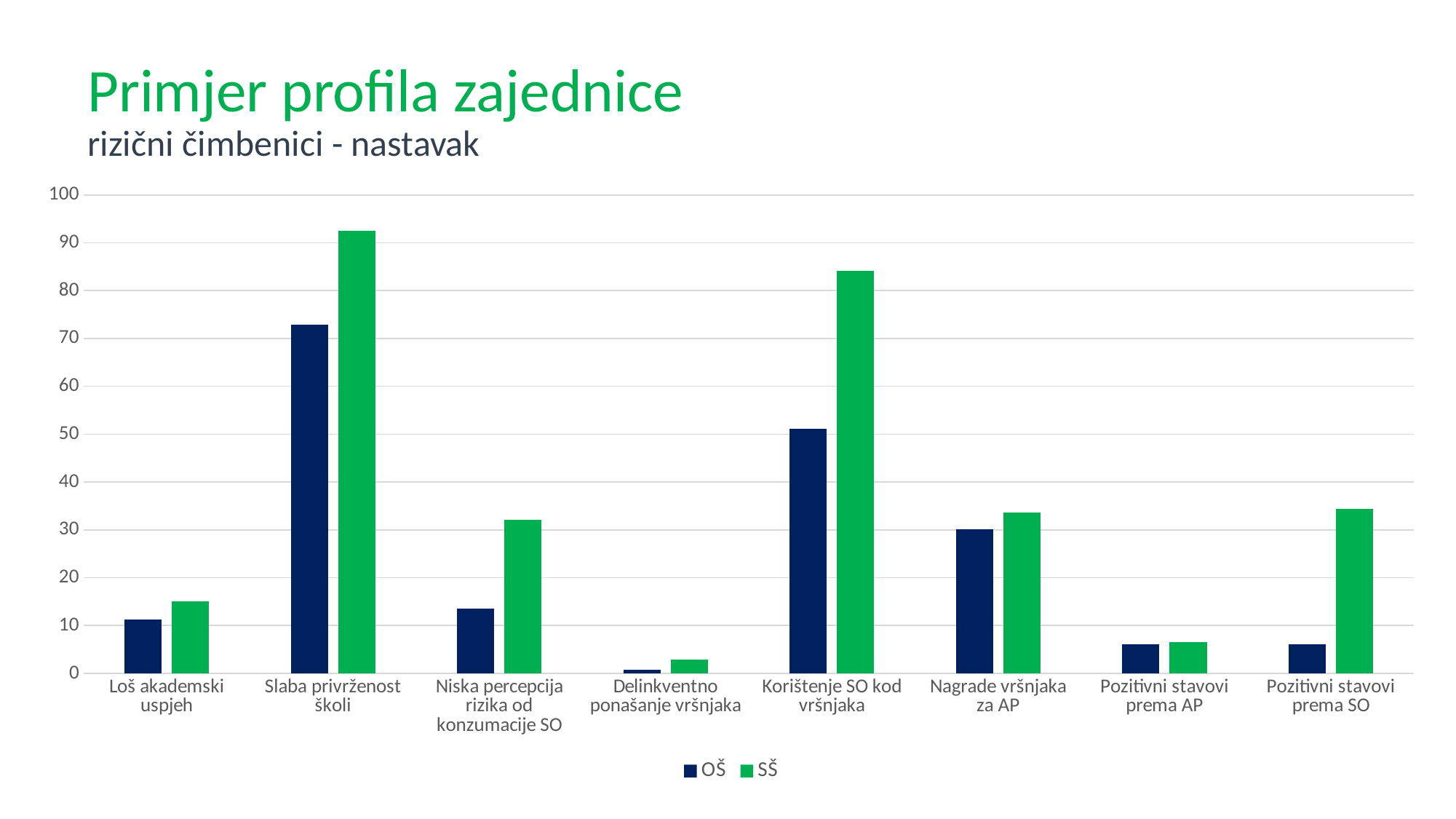
What kind of chart is shown on the slide? bar chart Is the OŠ value for Korištenje SO kod vršnjaka greater or less than 60? less For Pozitivni stavovi prema SO, which series has the larger value, OŠ or SŠ? SŠ Which category has the lowest SŠ value? Delinkventno ponašanje vršnjaka Is the SŠ value for Korištenje SO kod vršnjaka greater or less than 80? greater Which category has the highest OŠ value? Slaba privrženost školi What are the two series named in the legend? OŠ and SŠ Which category has the lowest OŠ value? Delinkventno ponašanje vršnjaka Is the SŠ value for Slaba privrženost školi greater or less than 90? greater How many categories are shown on the x axis? 8 How many series does the legend list? 2 Which category has the highest SŠ value? Slaba privrženost školi